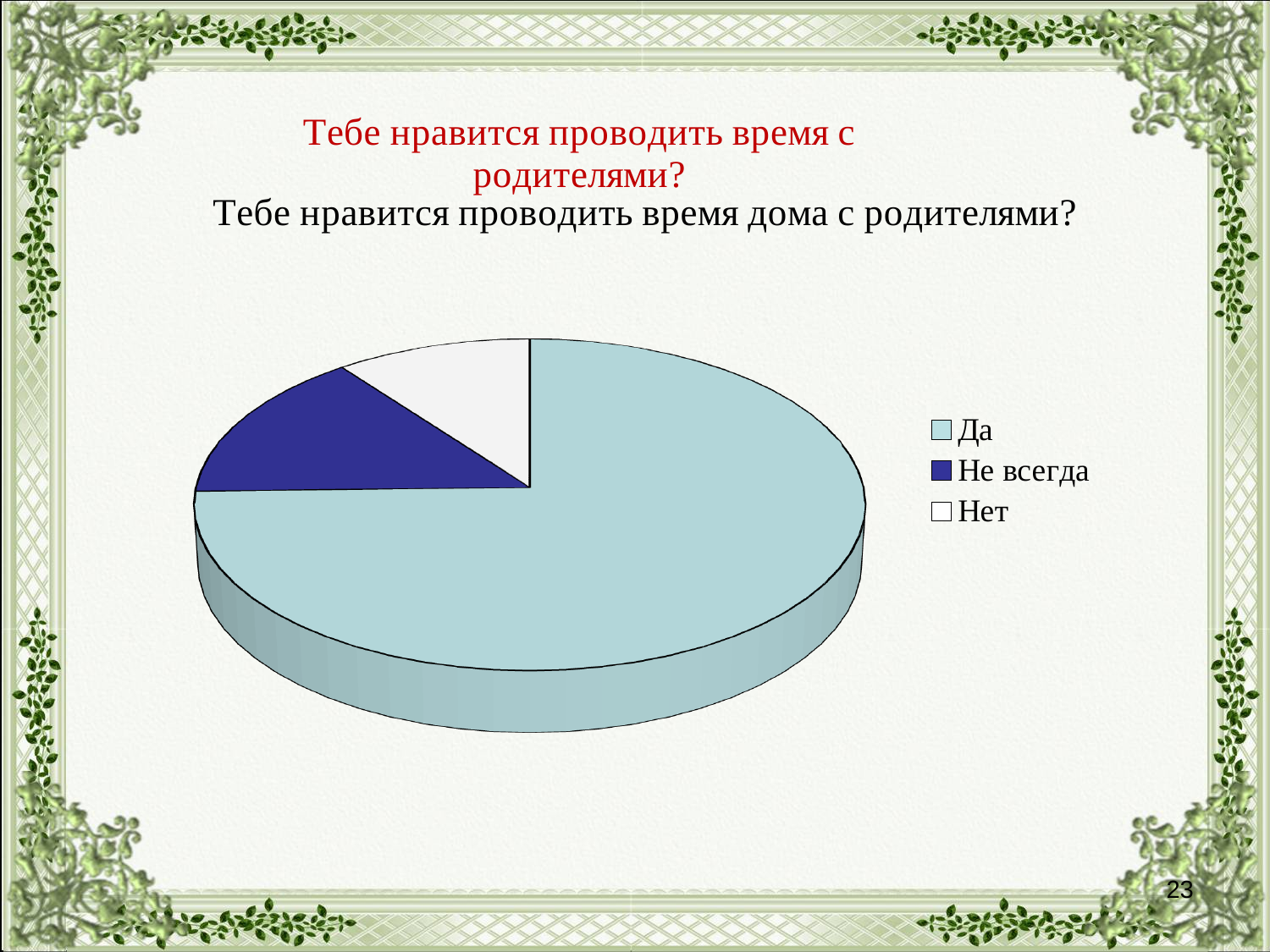
Does the "Да" slice take up more or less than half of the pie chart? more Which answer has the smallest slice in the pie chart? Нет What kind of chart is shown on the slide? pie chart Which slice is larger in the pie chart, "Не всегда" or "Нет"? Не всегда How many entries does the legend of the pie chart list? 3 How many slices does the pie chart have? 3 Which answer has the largest slice in the pie chart? Да What question is the pie chart about, according to the red title on the slide? Тебе нравится проводить время с родителями? Which slice is larger in the pie chart, "Да" or "Не всегда"? Да What colour is the "Не всегда" slice in the pie chart? dark blue